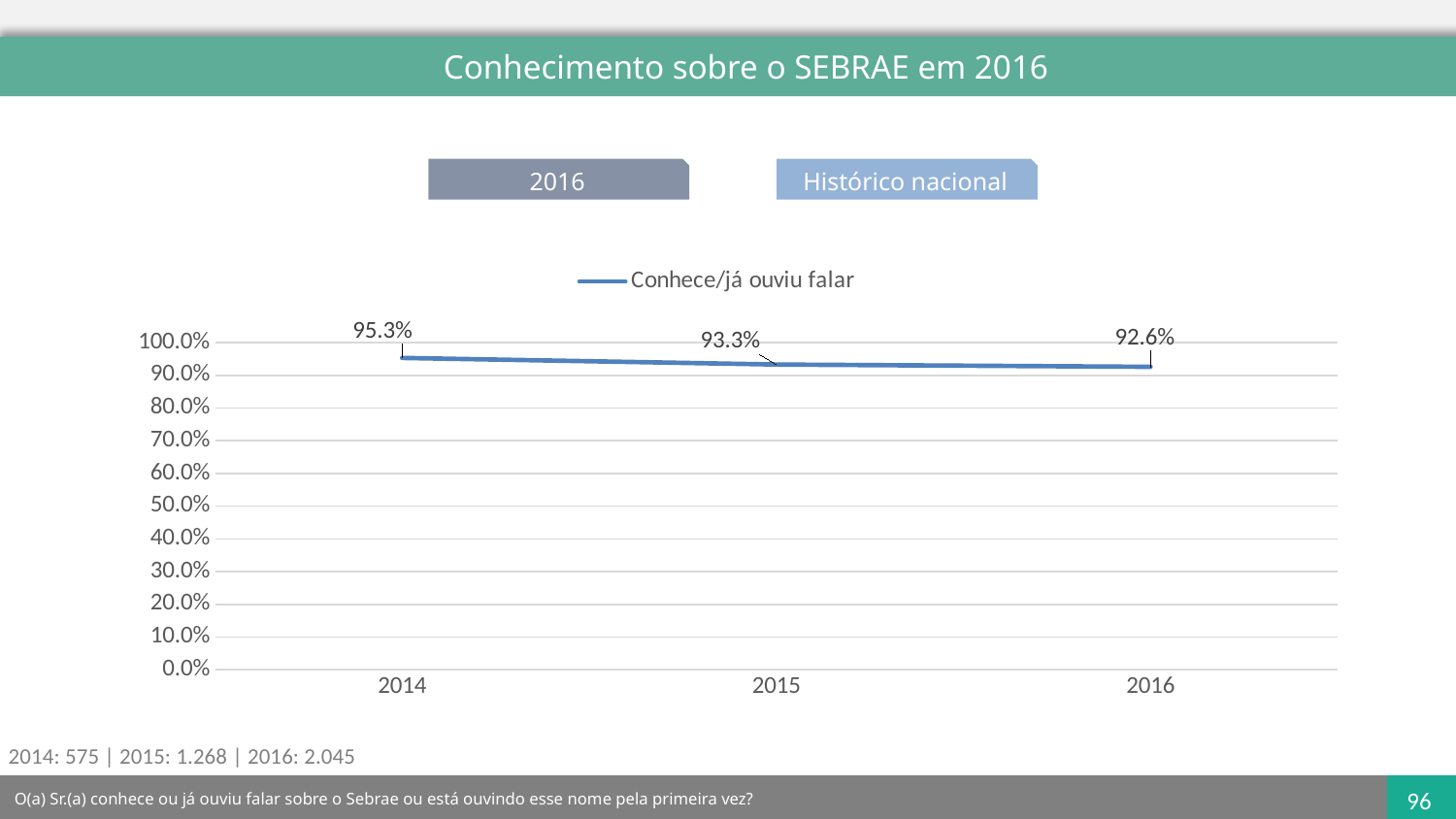
What is the value for 2016 in the 'Conhece/já ouviu falar' series? 92.6% What is the value for 2014 in the 'Conhece/já ouviu falar' series? 95.3% Which is larger, the value for 2015 or the value for 2016? 2015 Is the value for 2016 greater or less than 90.0%? greater Which year has the lowest value? 2016 What is the difference between the 2014 and 2015 values? 2.0% Do the values rise or fall from 2014 to 2016? fall What is the difference between the 2014 and 2016 values? 2.7% What is the value for 2015 in the 'Conhece/já ouviu falar' series? 93.3% How many years are plotted on the x axis? 3 Which year has the highest value? 2014 What kind of chart is shown? line chart